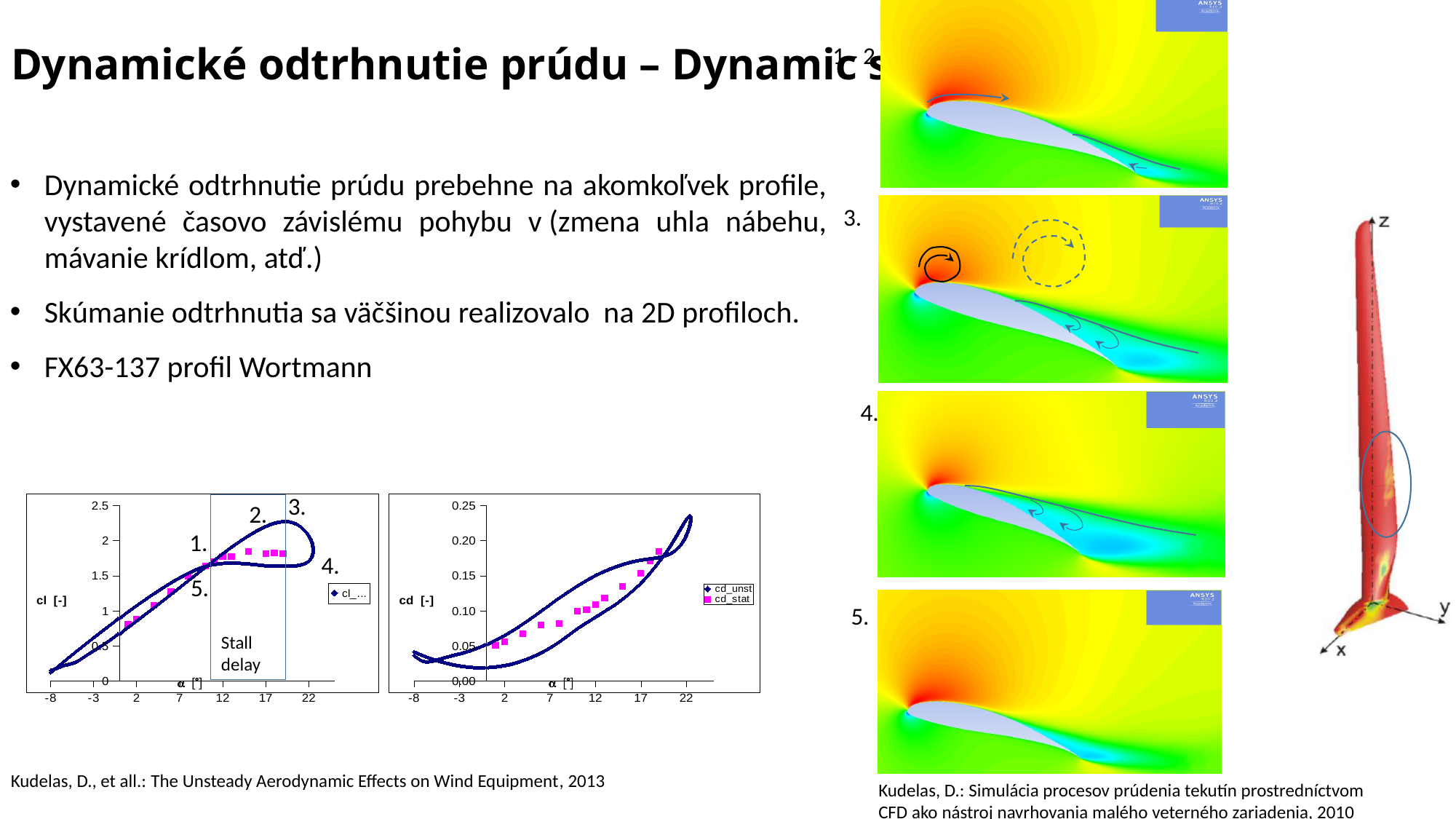
How many series does the legend of the right chart (cd [-] versus α [°]) list? 2 In the left chart (cl [-] versus α [°]), does the cl_stat series generally rise or fall as α increases from -8 to 12? rise In the left chart (cl [-] versus α [°]), is the peak value of the unsteady cl loop greater or less than 2? greater What is the highest tick value shown on the vertical axis of the right chart (cd [-] versus α [°])? 0.25 What is the label of the vertical axis of the left chart? cl [-] What is the highest tick value shown on the vertical axis of the left chart (cl [-] versus α [°])? 2.5 How many tick labels are shown on the horizontal axis (α [°]) of the left chart? 7 In the right chart (cd [-] versus α [°]), is the cd_stat value at α = 17 greater or less than 0.10? greater In the left chart (cl [-] versus α [°]), is the cl value at α = -8 greater or less than 0.5? less What kind of chart is the left chart (cl [-] versus α [°])? line chart What are the two legend entries of the right chart (cd [-] versus α [°])? cd_unst and cd_stat